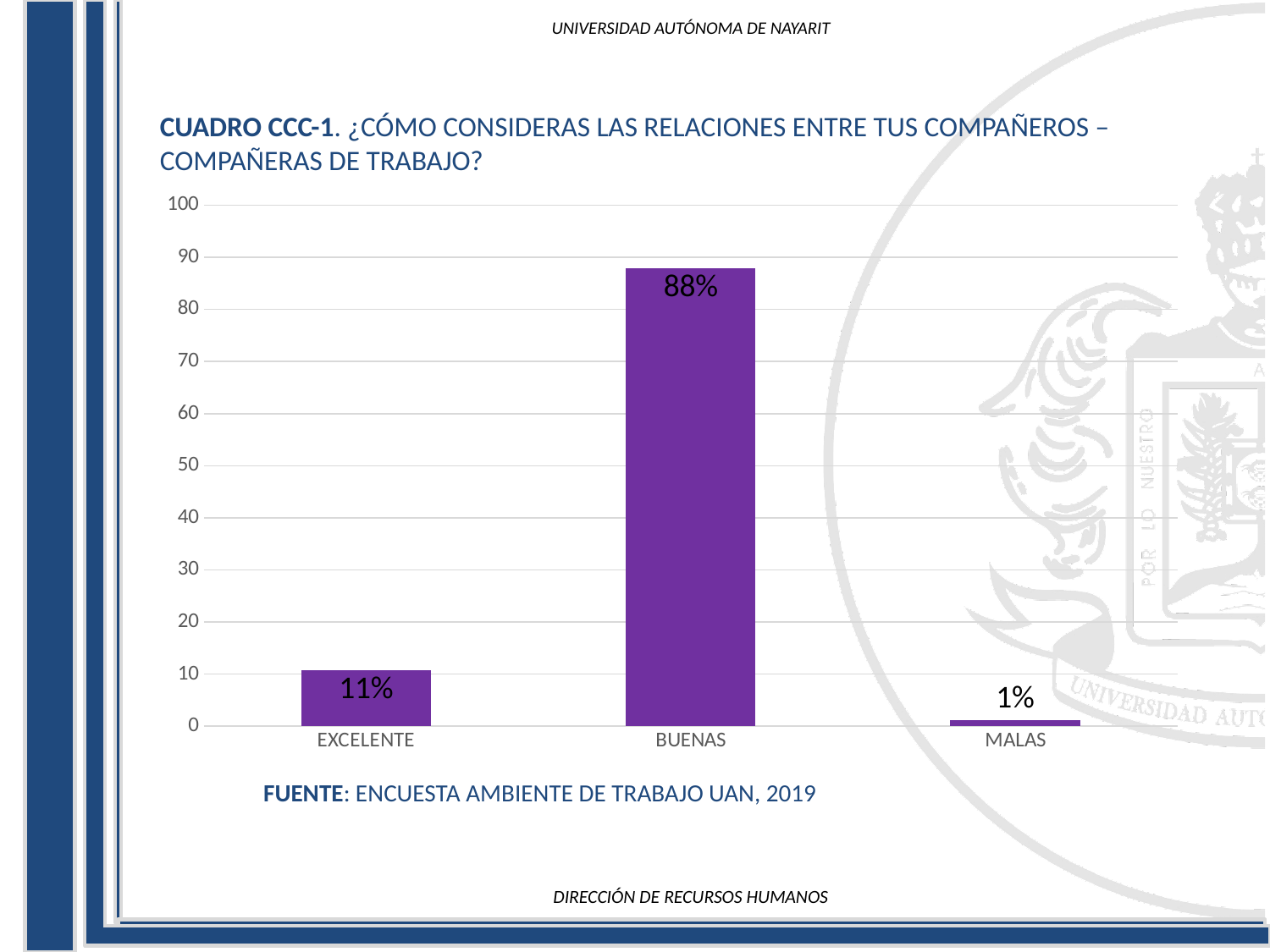
Is the value for BUENAS greater or less than 80? greater What is the value for MALAS? 1% Which category has the lowest value? MALAS How many categories are shown on the x axis? 3 What source is cited below the chart? ENCUESTA AMBIENTE DE TRABAJO UAN, 2019 What is the value for EXCELENTE? 11% Which category has the highest value? BUENAS What kind of chart is shown on the slide? bar chart Which is larger, the value for EXCELENTE or the value for MALAS? EXCELENTE What is the value for BUENAS? 88% What is the difference between the values for EXCELENTE and MALAS? 10% What is the difference between the values for BUENAS and EXCELENTE? 77%